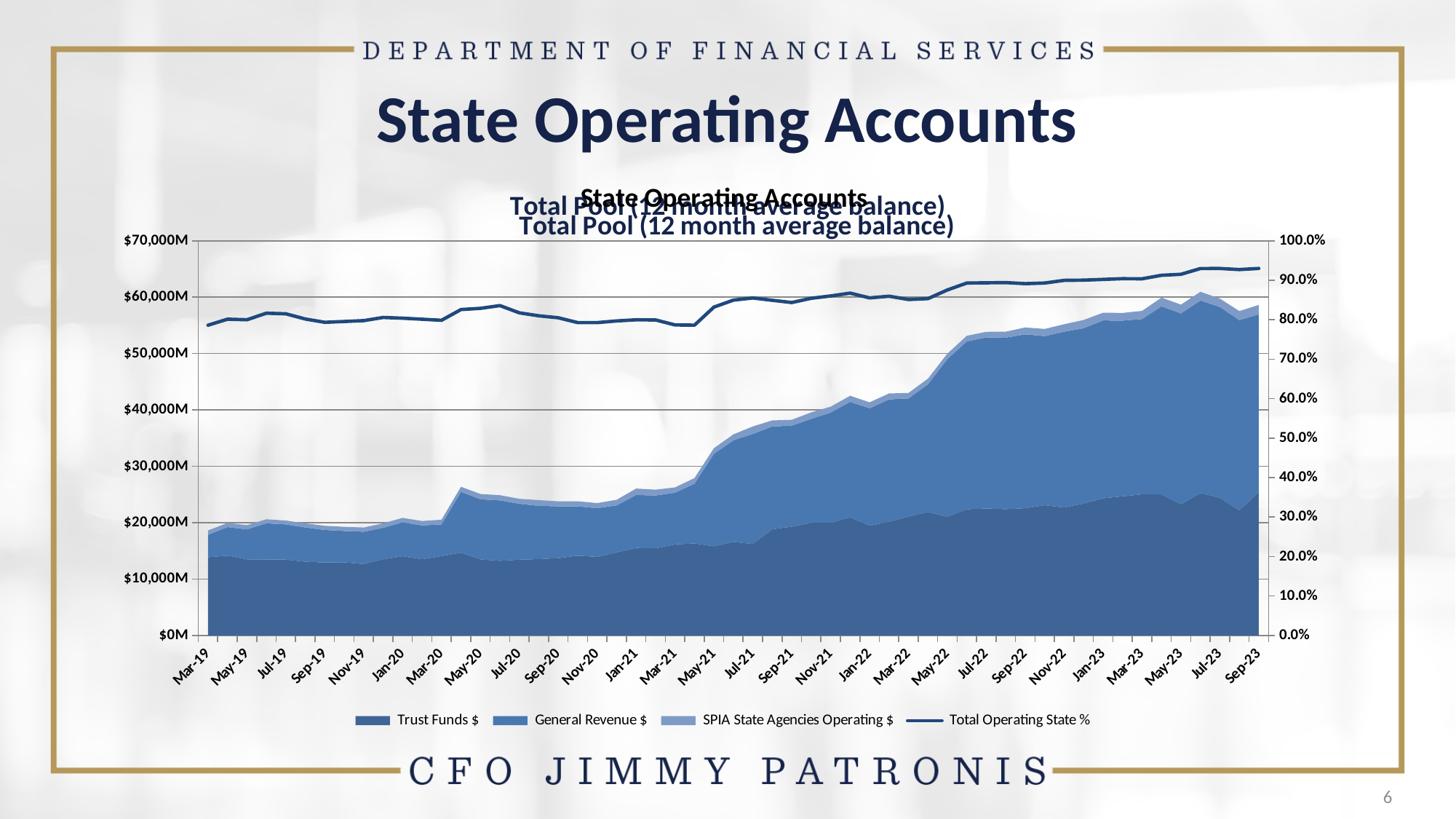
What kind of chart is shown on the slide? Stacked area chart with a line Does the total stacked balance generally rise or fall from Mar-19 to Sep-23? Rise Is the Trust Funds $ value at Mar-19 greater or less than $10,000M? greater Which is larger, the total stacked balance at Mar-19 or at Sep-23? Sep-23 Is the total stacked balance at Sep-23 greater or less than $50,000M? greater Does the Total Operating State % line generally rise or fall from Mar-19 to Sep-23? Rise Is the Total Operating State % value at Sep-23 greater or less than 90.0%? greater Which series is plotted as a line rather than an area? Total Operating State % What is the first series listed in the legend? Trust Funds $ How many series does the legend list? 4